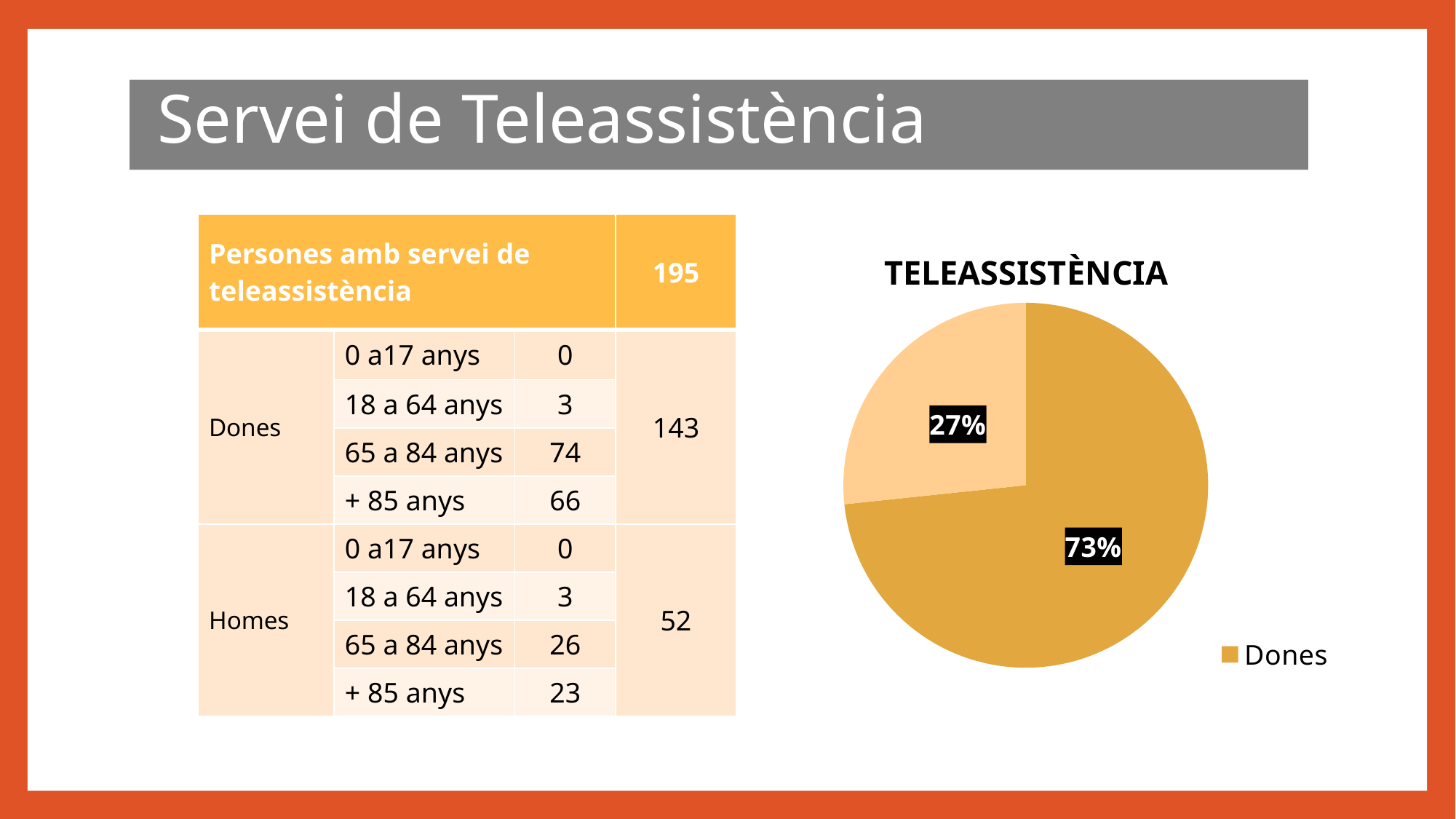
Which slice of the pie chart is the largest? Dones What percentage does the smaller, lighter slice of the pie chart show? 27% What is the difference in percentage points between the Dones slice and the smaller slice of the pie chart? 46 What is the title of the pie chart? TELEASSISTÈNCIA Is the share of the Dones slice greater or less than 50%? greater Is the Dones slice larger or smaller than the other slice of the pie chart? larger Which legend entry is shown for the pie chart? Dones How many entries does the pie chart's legend list? 1 What percentage does the Dones slice of the pie chart show? 73% How many slices does the pie chart have? 2 What kind of chart is shown on the slide? pie chart